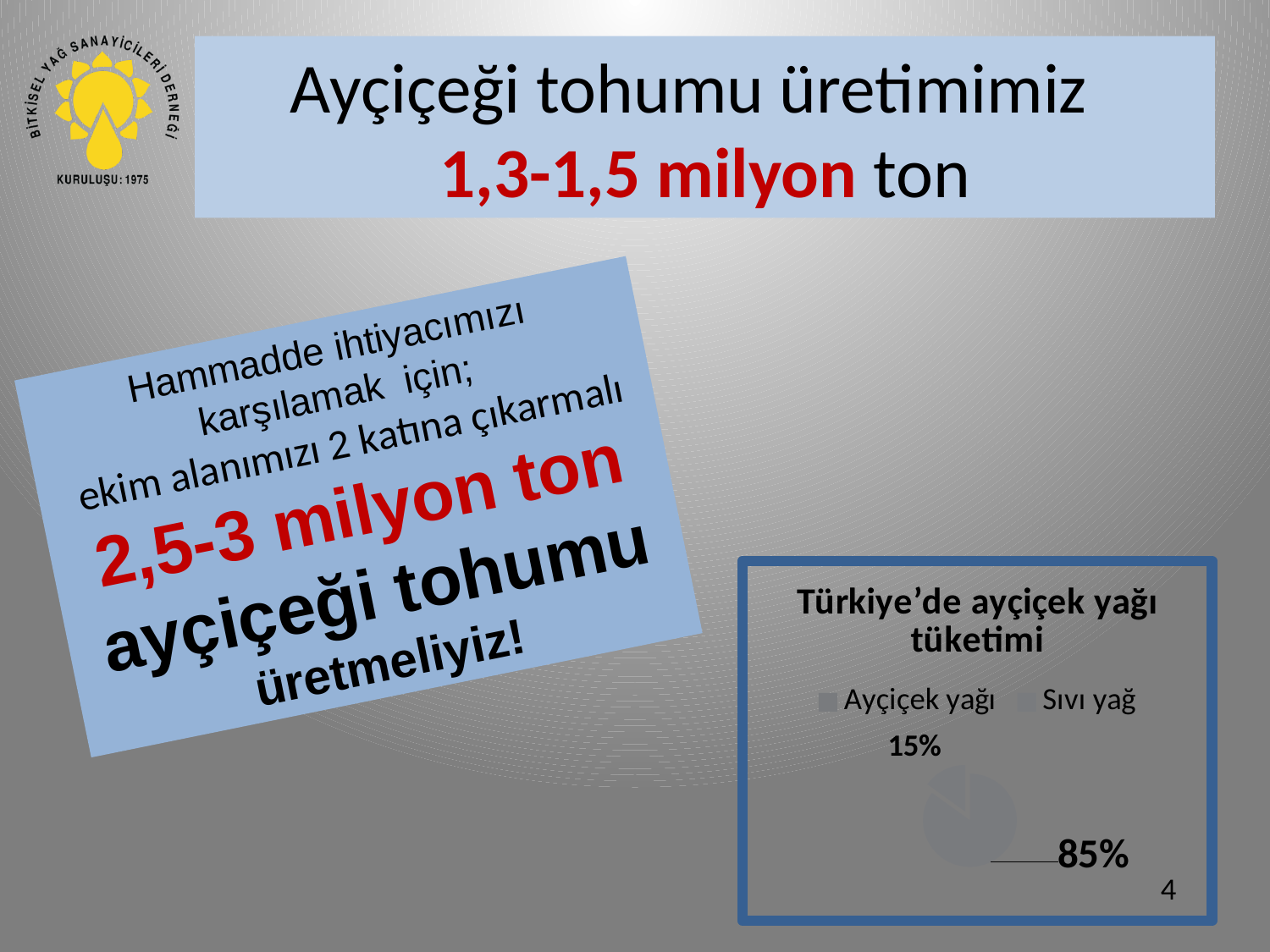
What is the title of the chart on the slide? Türkiye'de ayçiçek yağı tüketimi Which slice of the pie chart is the smallest? Sıvı yağ What is the difference in percentage points between the two slices of the pie chart? 70 What share of the pie does Ayçiçek yağı have? 85% What is the total of the two percentages shown on the pie chart? 100% Is the share for Ayçiçek yağı larger or smaller than the share for Sıvı yağ? larger How many slices does the pie chart have? 2 How many entries does the chart's legend list? 2 What kind of chart is shown on the slide? pie chart What share of the pie does Sıvı yağ have? 15% What are the two legend entries of the pie chart? Ayçiçek yağı and Sıvı yağ Which slice of the pie chart is the largest? Ayçiçek yağı